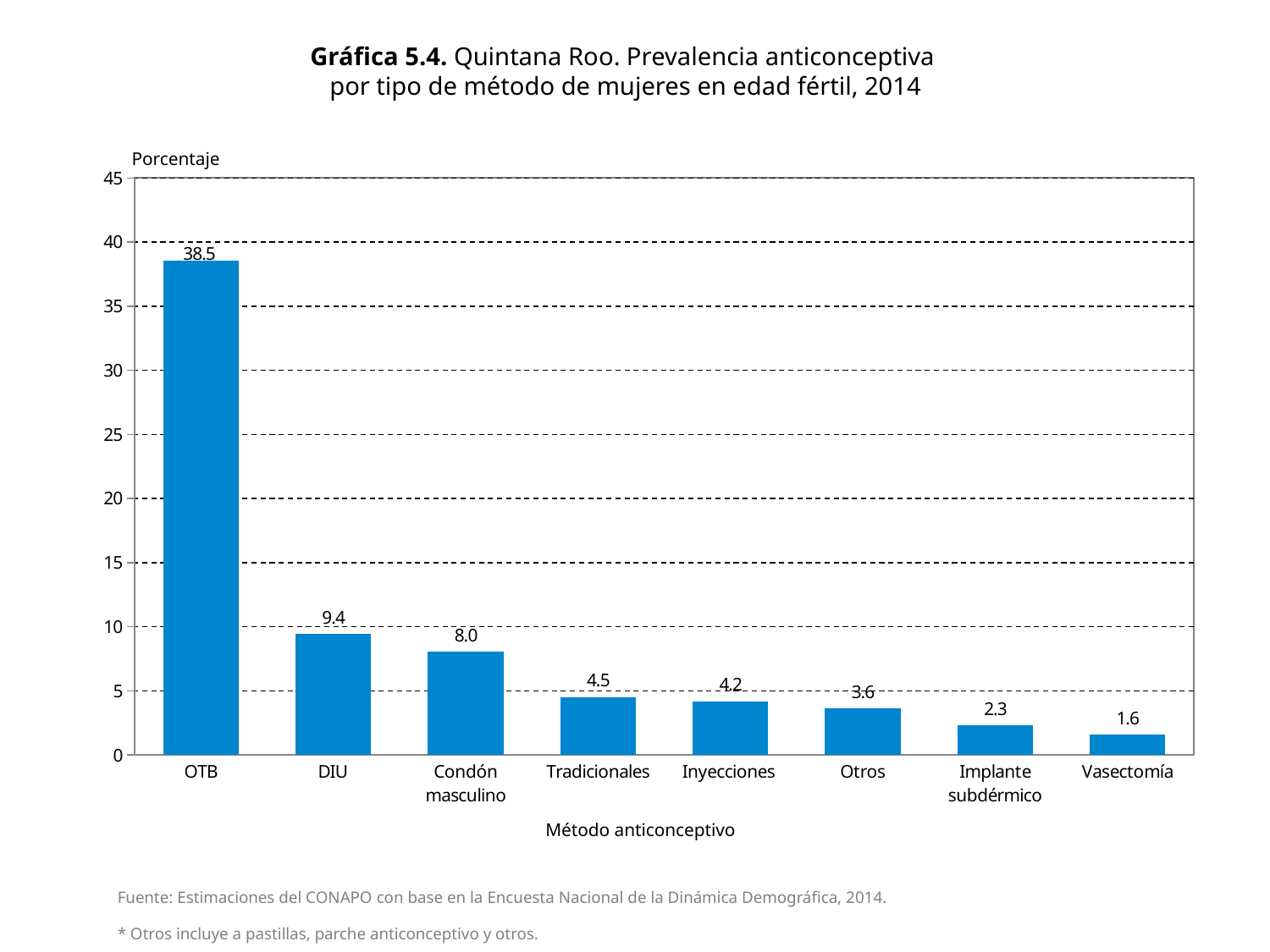
Which method has the lowest value? Vasectomía What is the label of the y axis? Porcentaje Is the value for Condón masculino greater or less than 10? less What is the difference between the values for Tradicionales and Otros? 0.9 What is the value for Implante subdérmico? 2.3 Which method has the highest value? OTB What is the value for OTB? 38.5 Which is larger, the value for DIU or the value for Inyecciones? DIU What is the value for Condón masculino? 8.0 What is the difference between the values for OTB and DIU? 29.1 How many contraceptive methods are shown on the x axis? 8 What kind of chart is shown on the slide? bar chart